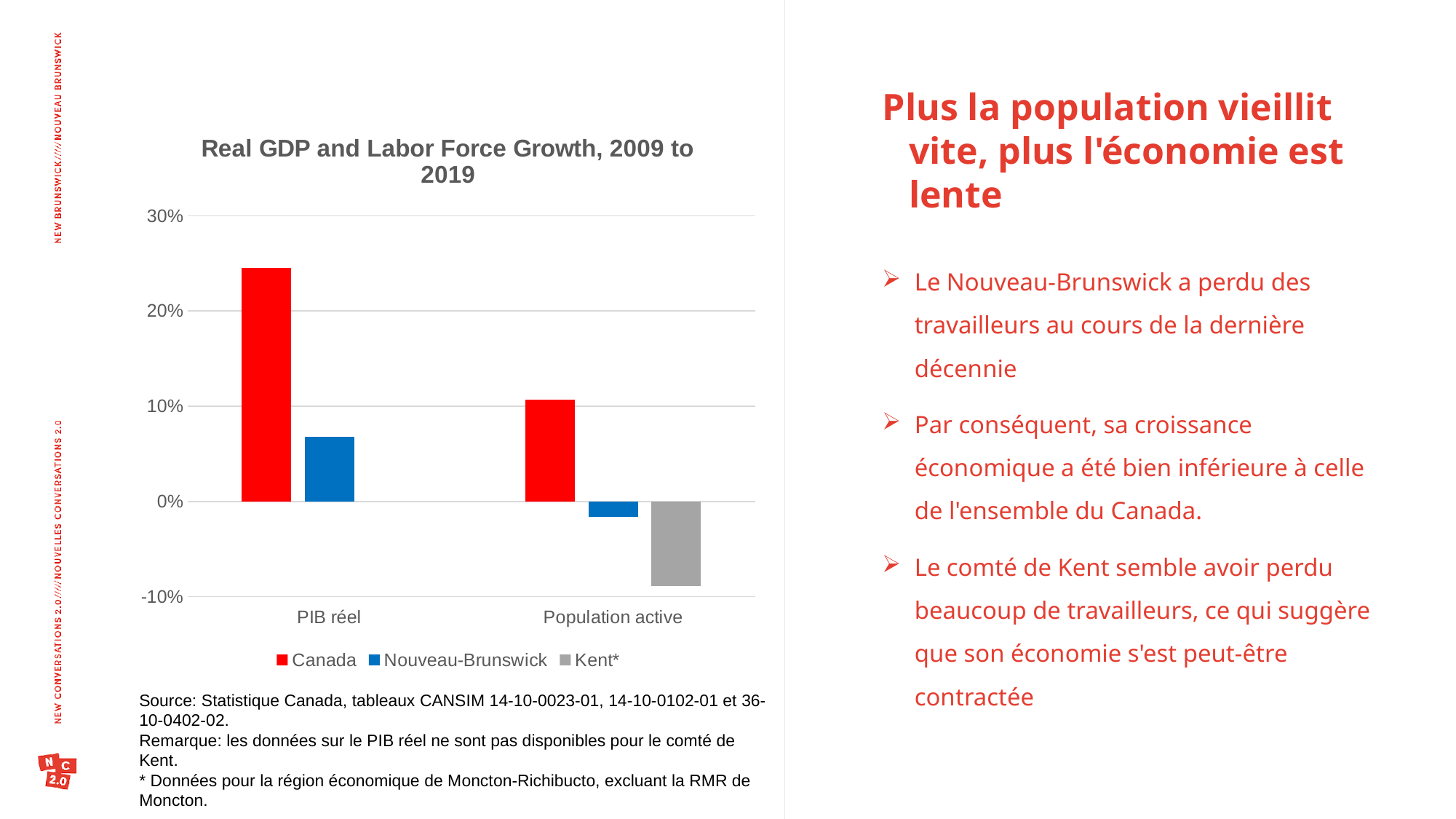
Is the value for Kent* in Population active greater or less than 0%? less Which colour represents the Kent* series in the legend? grey Is the value for Nouveau-Brunswick in PIB réel greater or less than 10%? less What is the title of the chart? Real GDP and Labor Force Growth, 2009 to 2019 Which series has the lowest value for Population active? Kent* What kind of chart is shown on the slide? bar chart How many series does the legend list? 3 Which is larger: Canada's value for PIB réel or Canada's value for Population active? PIB réel How many categories are shown on the x axis? 2 Which is larger: Nouveau-Brunswick's value for Population active or Kent*'s value for Population active? Nouveau-Brunswick Which series has the highest value for PIB réel? Canada Is the value for Canada in PIB réel greater or less than 20%? greater